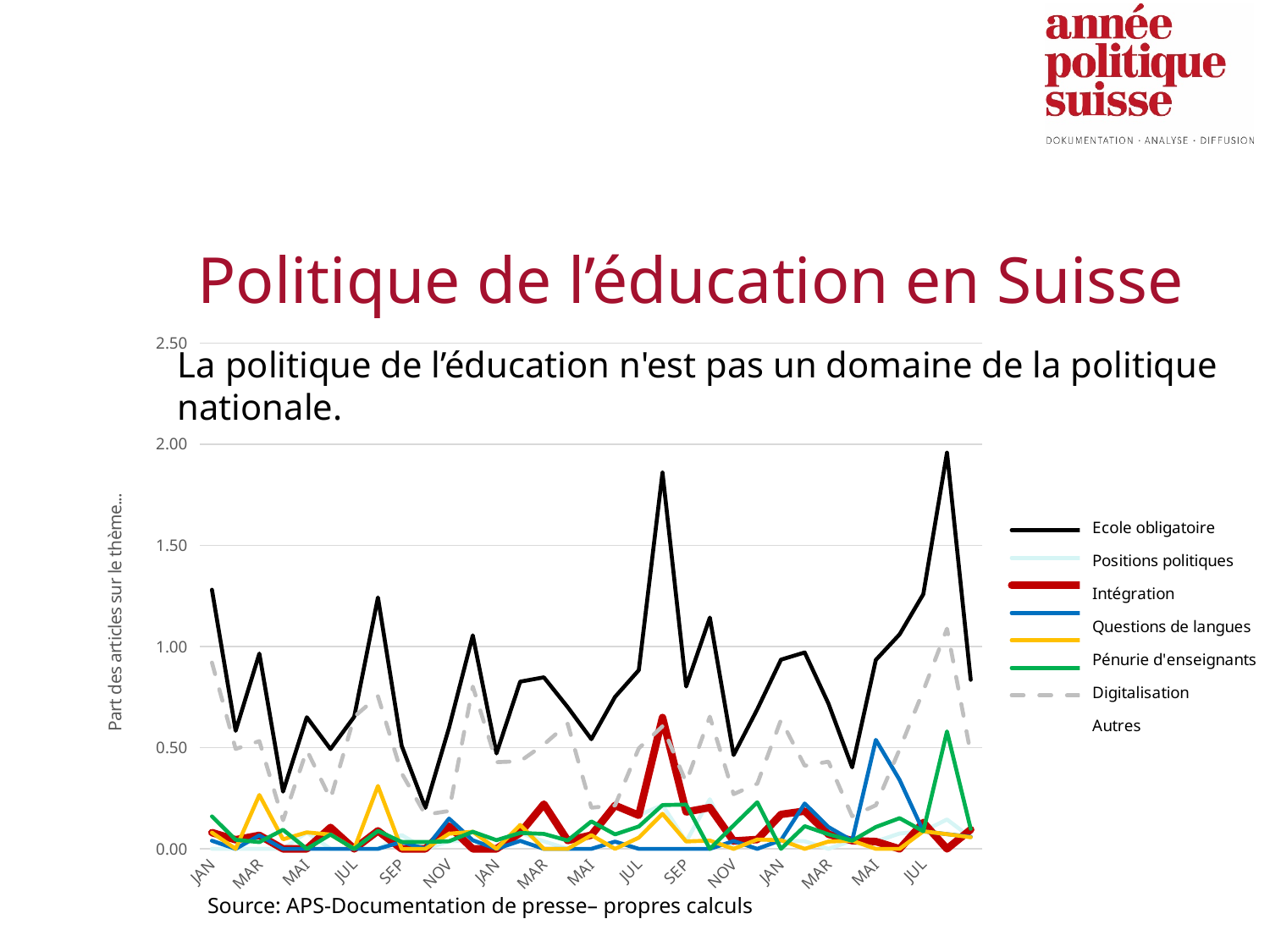
Is the peak value of the Positions politiques series greater or less than 0.50? less How many series does the legend list? 7 Is the highest value of the Ecole obligatoire series greater or less than 1.50? greater What is the highest value shown on the y axis? 2.50 At the first JAN, which is larger: Ecole obligatoire or Digitalisation? Ecole obligatoire What kind of chart is shown on the slide? line chart Which series has the highest values across the chart? Ecole obligatoire Is the peak value of the Digitalisation series greater or less than 0.50? greater Which series is drawn with a dashed grey line? Digitalisation